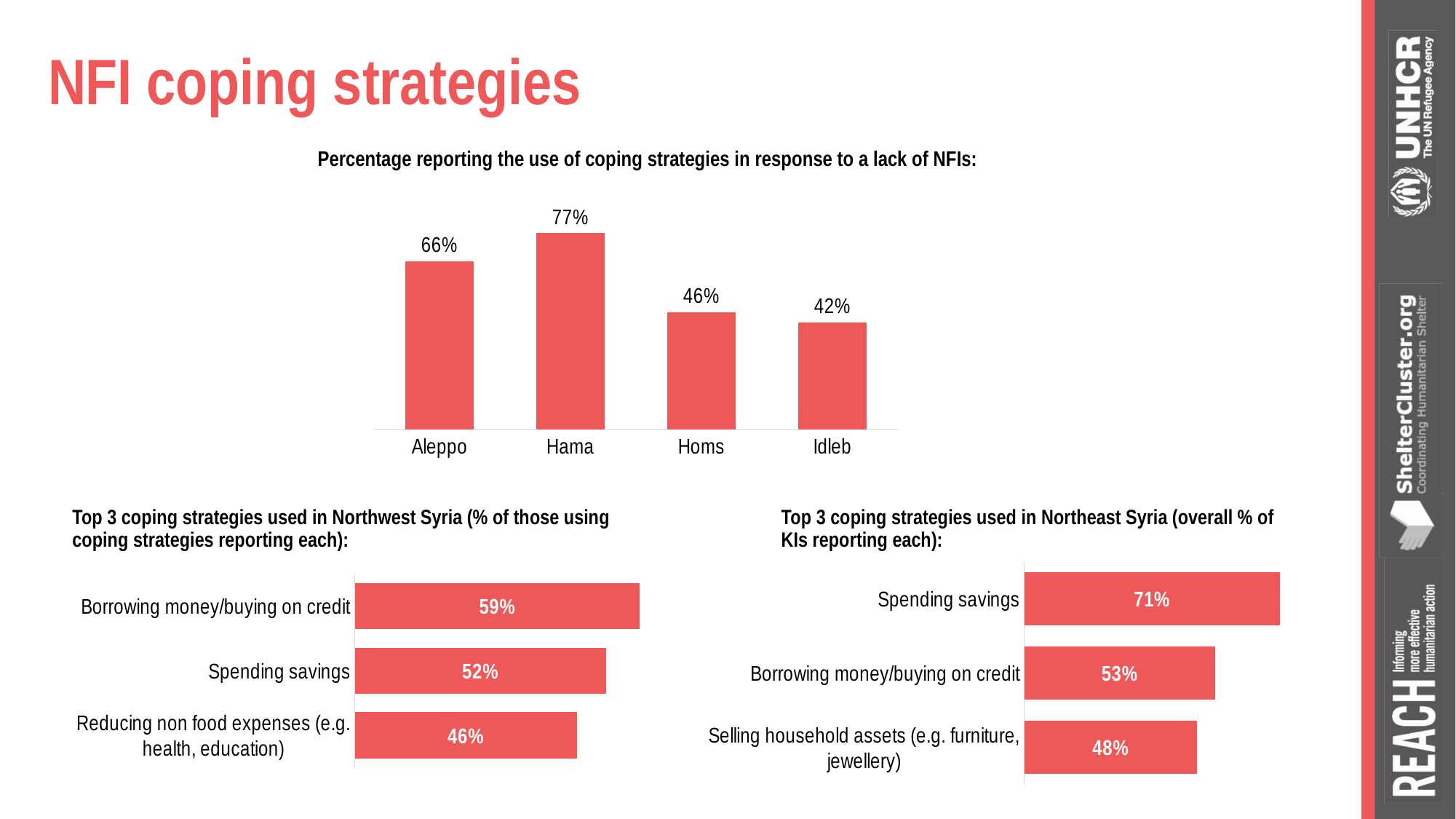
In the bottom-left chart 'Top 3 coping strategies used in Northwest Syria', which strategy has the highest value? Borrowing money/buying on credit In the bottom-left chart 'Top 3 coping strategies used in Northwest Syria', what is the value for Spending savings? 52% In the top chart 'Percentage reporting the use of coping strategies in response to a lack of NFIs', which governorate has the highest value? Hama In the bottom-right chart 'Top 3 coping strategies used in Northeast Syria', what is the difference between Spending savings and Borrowing money/buying on credit? 18% In the top chart 'Percentage reporting the use of coping strategies in response to a lack of NFIs', which governorate has the lowest value? Idleb Which is larger: Spending savings in the bottom-left Northwest Syria chart or Spending savings in the bottom-right Northeast Syria chart? Northeast Syria (71%) In the bottom-left chart 'Top 3 coping strategies used in Northwest Syria', which strategy has the lowest value? Reducing non food expenses (e.g. health, education) What kind of chart is the top chart 'Percentage reporting the use of coping strategies in response to a lack of NFIs'? Bar chart In the top chart 'Percentage reporting the use of coping strategies in response to a lack of NFIs', what is the difference between Aleppo and Homs? 20% In the top chart 'Percentage reporting the use of coping strategies in response to a lack of NFIs', what is the value for Hama? 77% In the top chart 'Percentage reporting the use of coping strategies in response to a lack of NFIs', how many governorates are shown? 4 In the bottom-right chart 'Top 3 coping strategies used in Northeast Syria', what is the value for Selling household assets (e.g. furniture, jewellery)? 48%